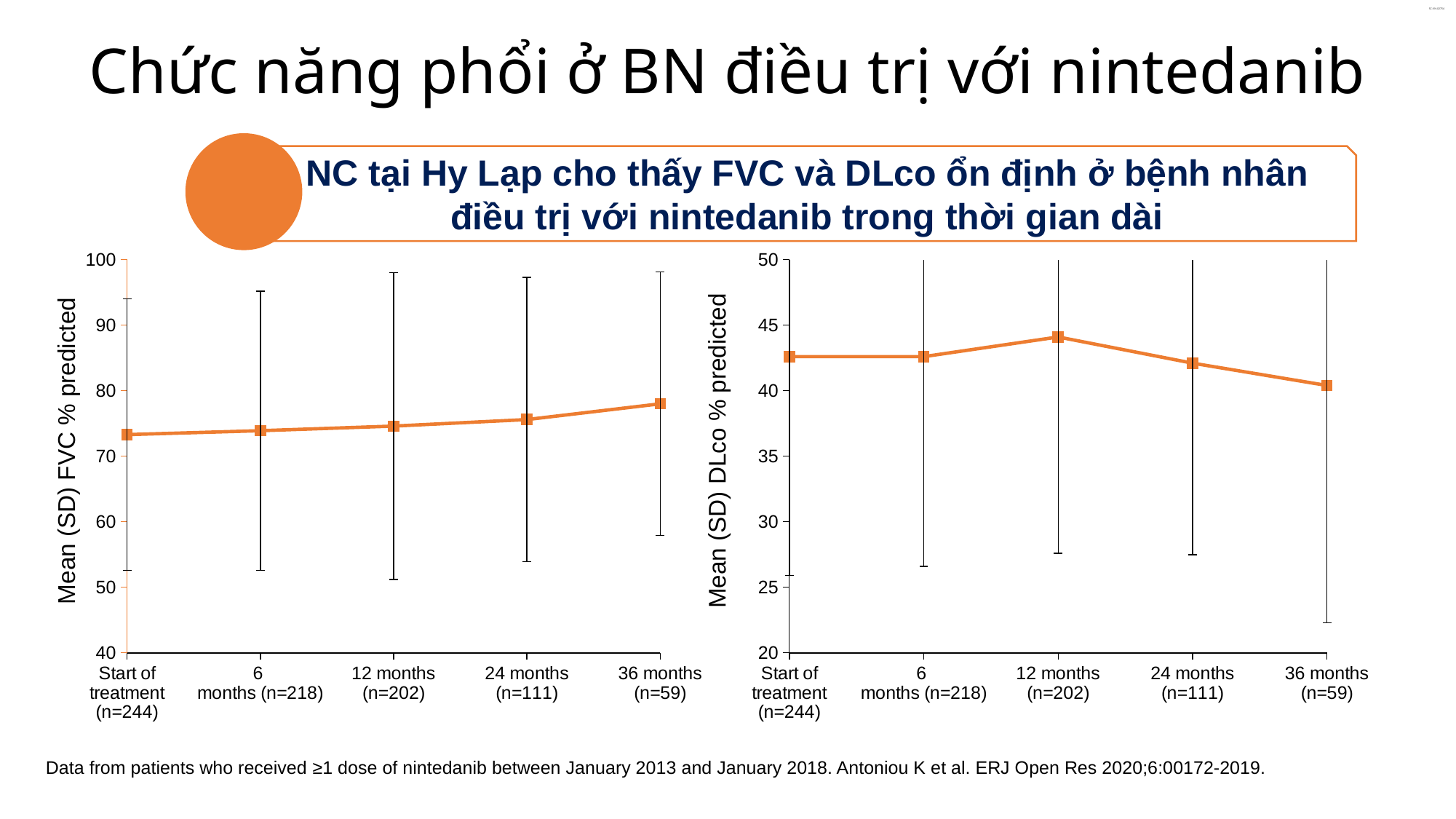
In the left chart (FVC % predicted), is the value at 36 months greater or less than 80? less In the left chart (FVC % predicted), do the values rise or fall from Start of treatment to 36 months? rise In the left chart (FVC % predicted), at which time point is the mean value highest? 36 months (n=59) In the right chart (DLco % predicted), which is larger: the value at Start of treatment or the value at 36 months? Start of treatment What type of chart is the left chart (Mean (SD) FVC % predicted)? line chart In the right chart (DLco % predicted), at which time point is the mean value lowest? 36 months (n=59) In the left chart (FVC % predicted), is the value at Start of treatment greater or less than 70? greater How many time points are plotted in the right chart (Mean (SD) DLco % predicted)? 5 What is the y-axis label of the right chart? Mean (SD) DLco % predicted In the right chart (DLco % predicted), is the value at 12 months greater or less than 45? less In the right chart (DLco % predicted), at which time point is the mean value highest? 12 months (n=202)